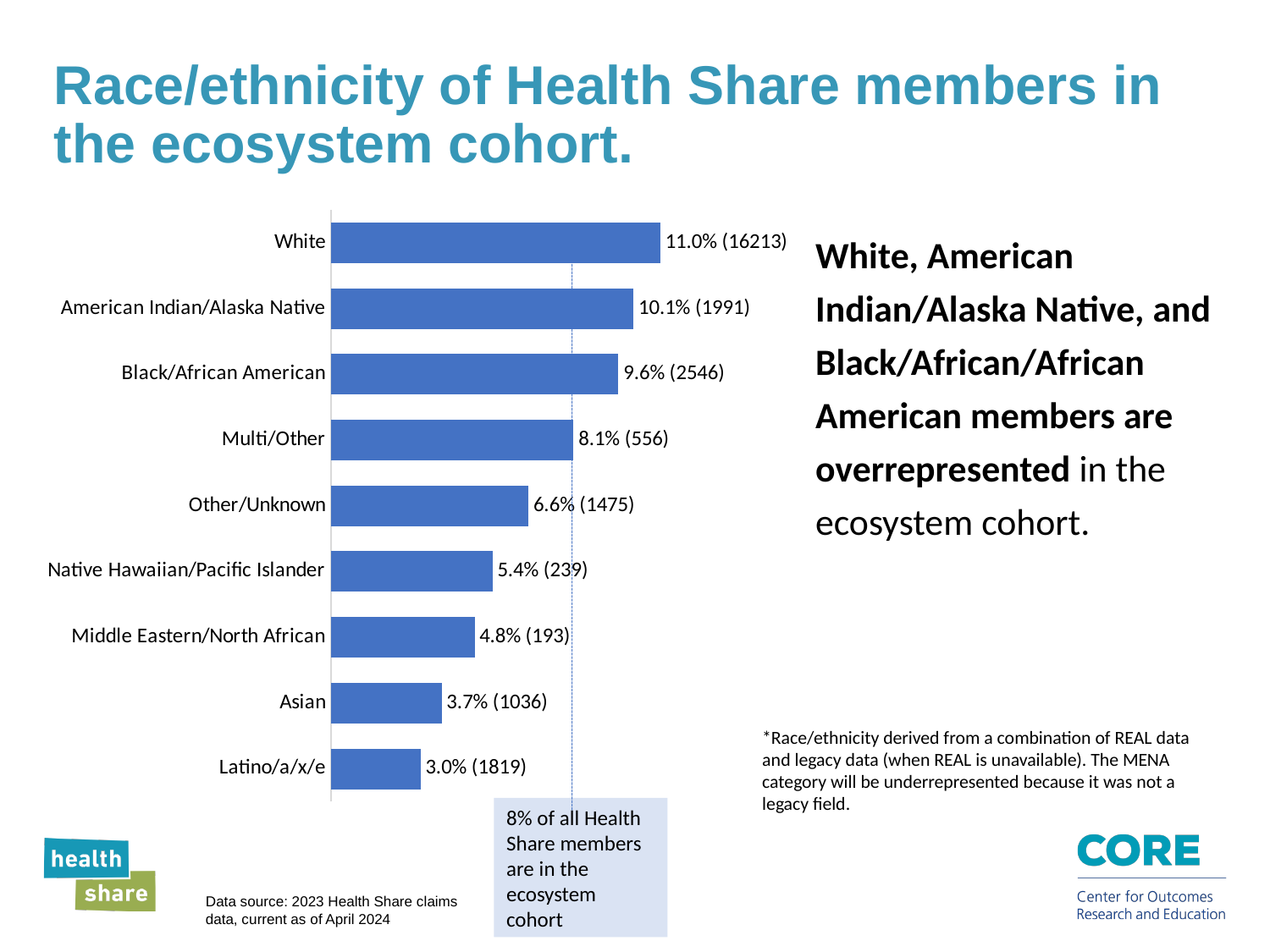
Which has a higher percentage, Multi/Other or Other/Unknown? Multi/Other What kind of chart is this? Bar chart What count is shown in parentheses for Black/African American? 2546 What percentage is shown for White members? 11.0% What does the dashed vertical reference line on the chart represent? 8% of all Health Share members are in the ecosystem cohort Which category has the lowest percentage? Latino/a/x/e How many race/ethnicity categories are plotted? 9 What is the difference in percentage points between White and Latino/a/x/e? 8.0 What percentage is shown for Middle Eastern/North African? 4.8% What is the difference in percentage points between American Indian/Alaska Native and Black/African American? 0.5 What is the data label for Asian? 3.7% (1036) Which category has the highest percentage? White